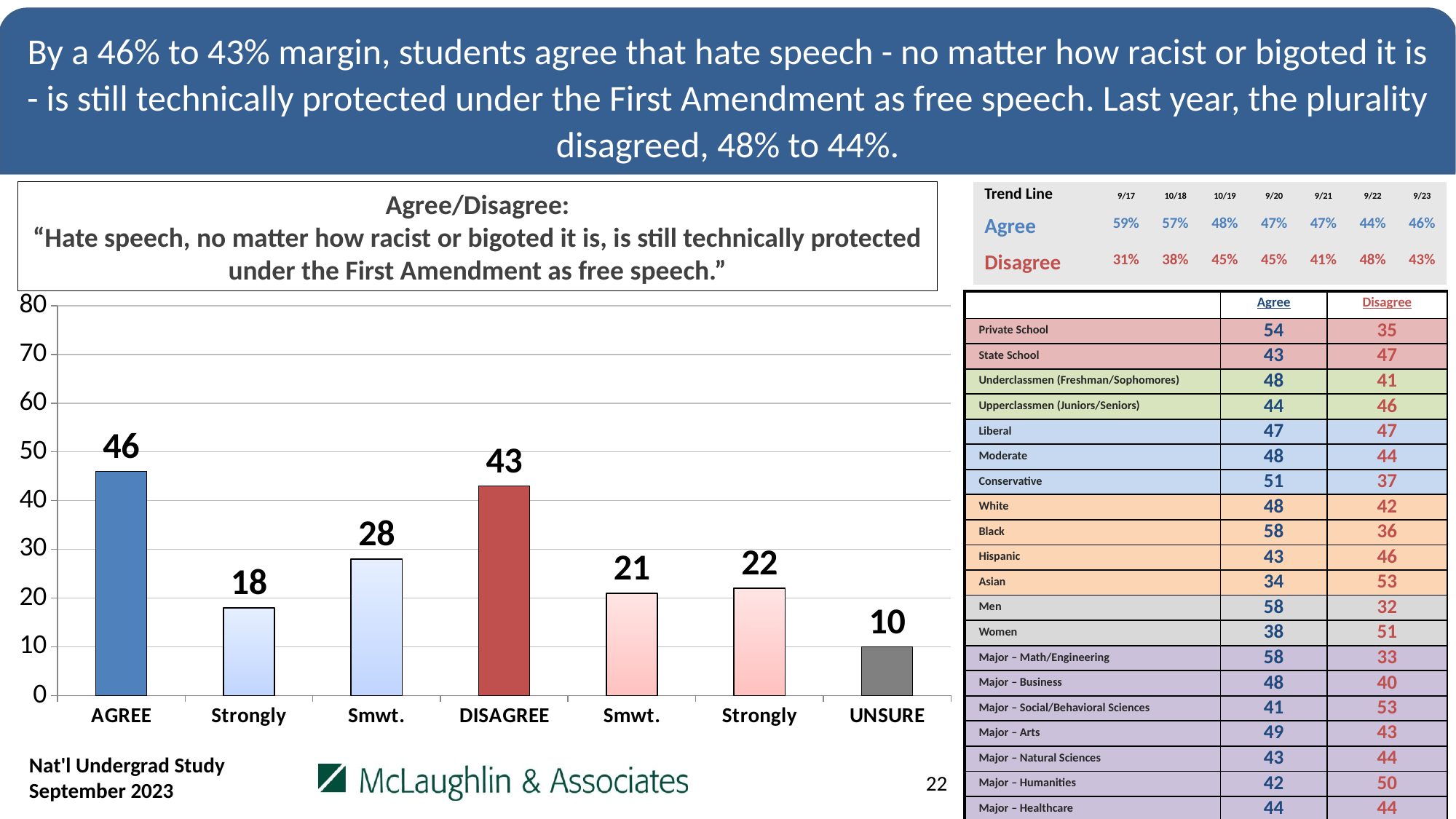
What is the highest value shown on the chart's vertical axis? 80 Which bar in the chart has the lowest value? UNSURE What is the value of the AGREE bar? 46 What type of chart is shown on the slide? Bar chart What is the value of the DISAGREE bar? 43 What is the value of the Smwt. bar under DISAGREE (the fifth bar from the left)? 21 Which bar in the chart has the highest value? AGREE How many bars are plotted in the chart? 7 Which is larger: the Smwt. bar under AGREE or the Smwt. bar under DISAGREE? Smwt. under AGREE What is the difference between the AGREE bar and the DISAGREE bar? 3 What is the value of the Strongly bar under AGREE (the second bar from the left)? 18 What is the value of the UNSURE bar? 10